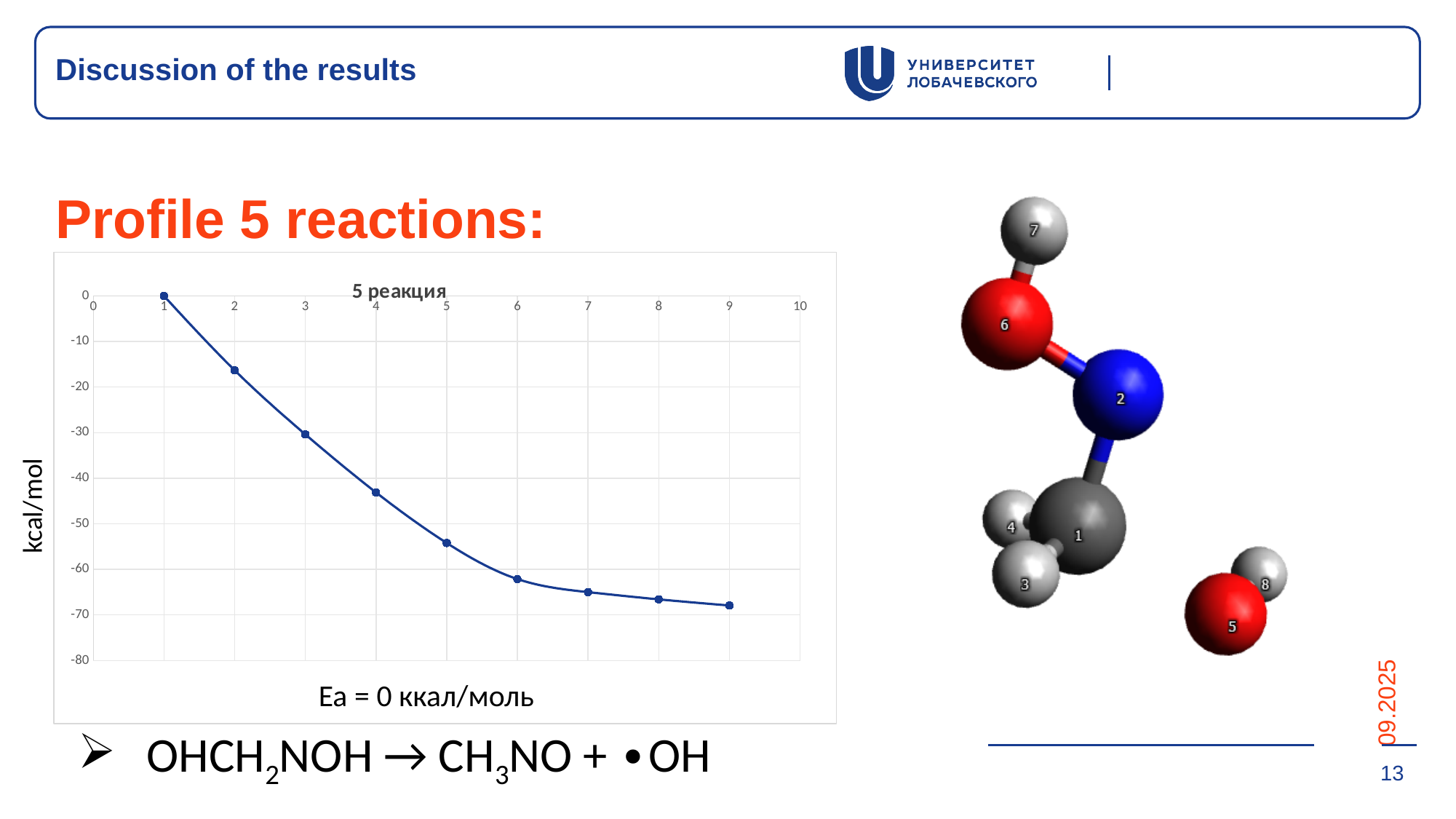
At which x value is the plotted value lowest? 9 Is the value at x = 2 greater or less than -10? less Do the values rise or fall as x increases along the chart? fall Is the value at x = 6 greater or less than -70? greater What kind of chart is shown on the slide? line chart What is the label on the vertical axis of the chart? kcal/mol What is the title of the chart? 5 реакция Is the value at x = 3 greater or less than -20? less Which has the larger value, the point at x = 2 or the point at x = 5? x = 2 At which x value is the plotted value highest? 1 How many data points are plotted on the line? 9 What is the value at x = 1 on the chart? 0